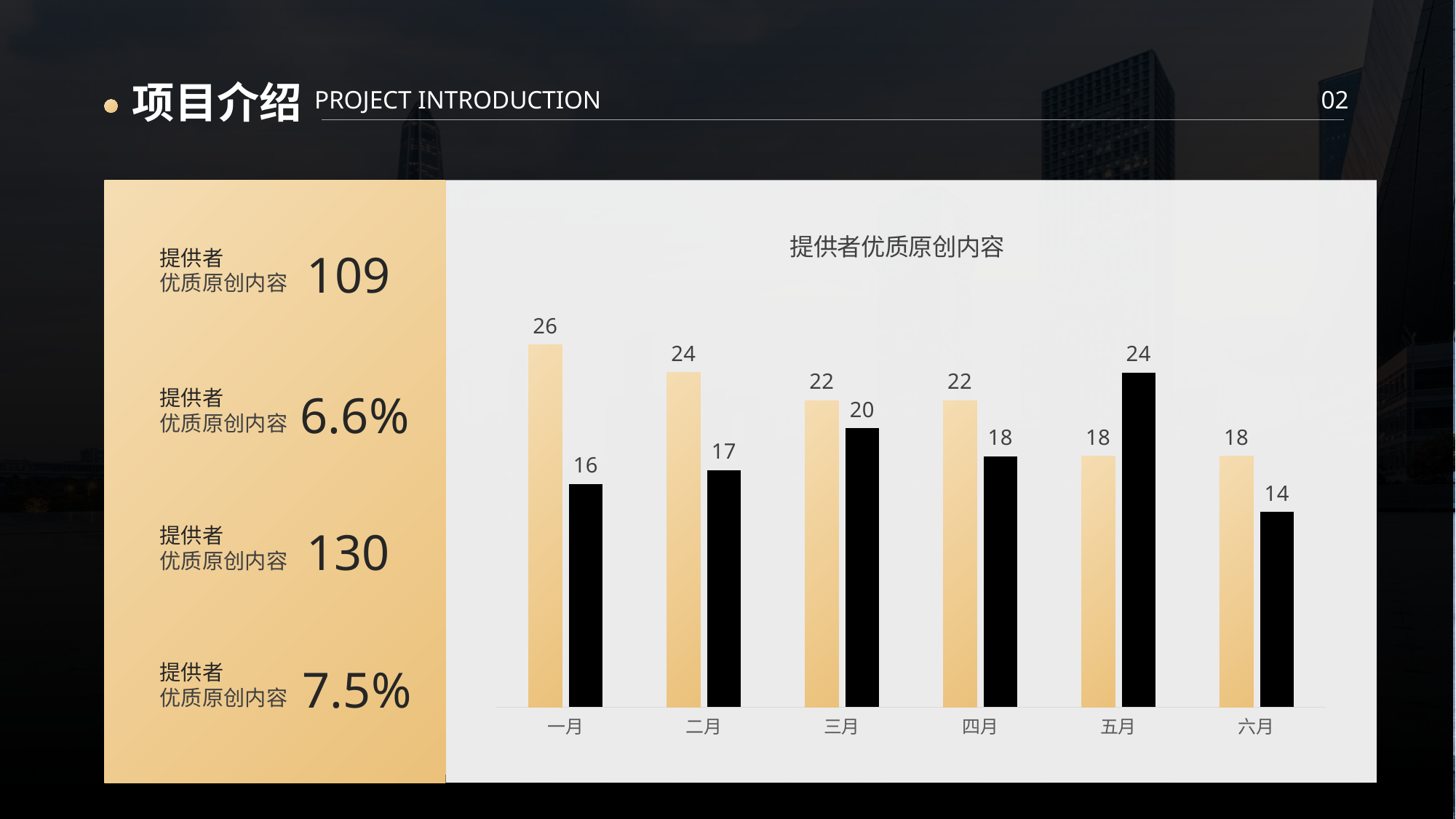
Do the gold bars rise or fall from 一月 to 六月? fall What is the value of the black bar for 五月? 24 What is the value of the gold bar for 一月? 26 Which is larger for 五月, the gold bar or the black bar? the black bar How many categories are shown on the x axis of the chart? 6 Which month has the highest gold bar? 一月 What is the title of the chart? 提供者优质原创内容 Which month has the lowest black bar? 六月 What type of chart is shown on the slide? bar chart What is the value of the black bar for 六月? 14 What is the difference between the gold bar and the black bar for 一月? 10 What is the value of the gold bar for 三月? 22